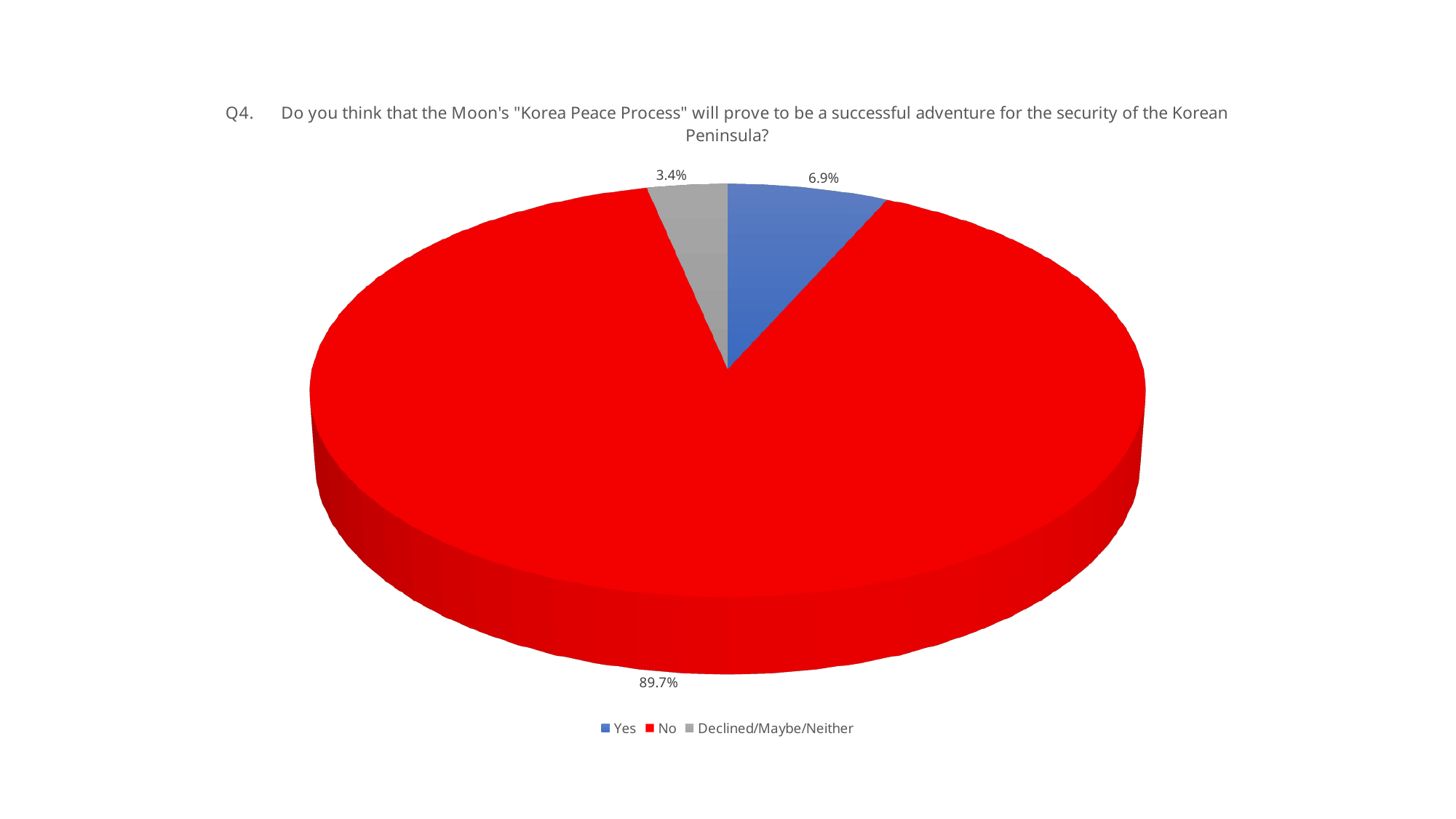
Which response has the largest share of the pie? No What is the combined share of "Yes" and "Declined/Maybe/Neither"? 10.3% Which category is shown in grey in the legend? Declined/Maybe/Neither What colour is the "No" slice? Red What percentage of respondents answered "No"? 89.7% What is the difference in percentage points between the "No" and "Yes" shares? 82.8 What percentage of respondents are in the "Declined/Maybe/Neither" category? 3.4% What kind of chart is shown on the slide? Pie chart How many categories does the pie chart show? 3 Which response has the smallest share of the pie? Declined/Maybe/Neither What percentage of respondents answered "Yes"? 6.9% Which is larger, the "Yes" share or the "Declined/Maybe/Neither" share? Yes